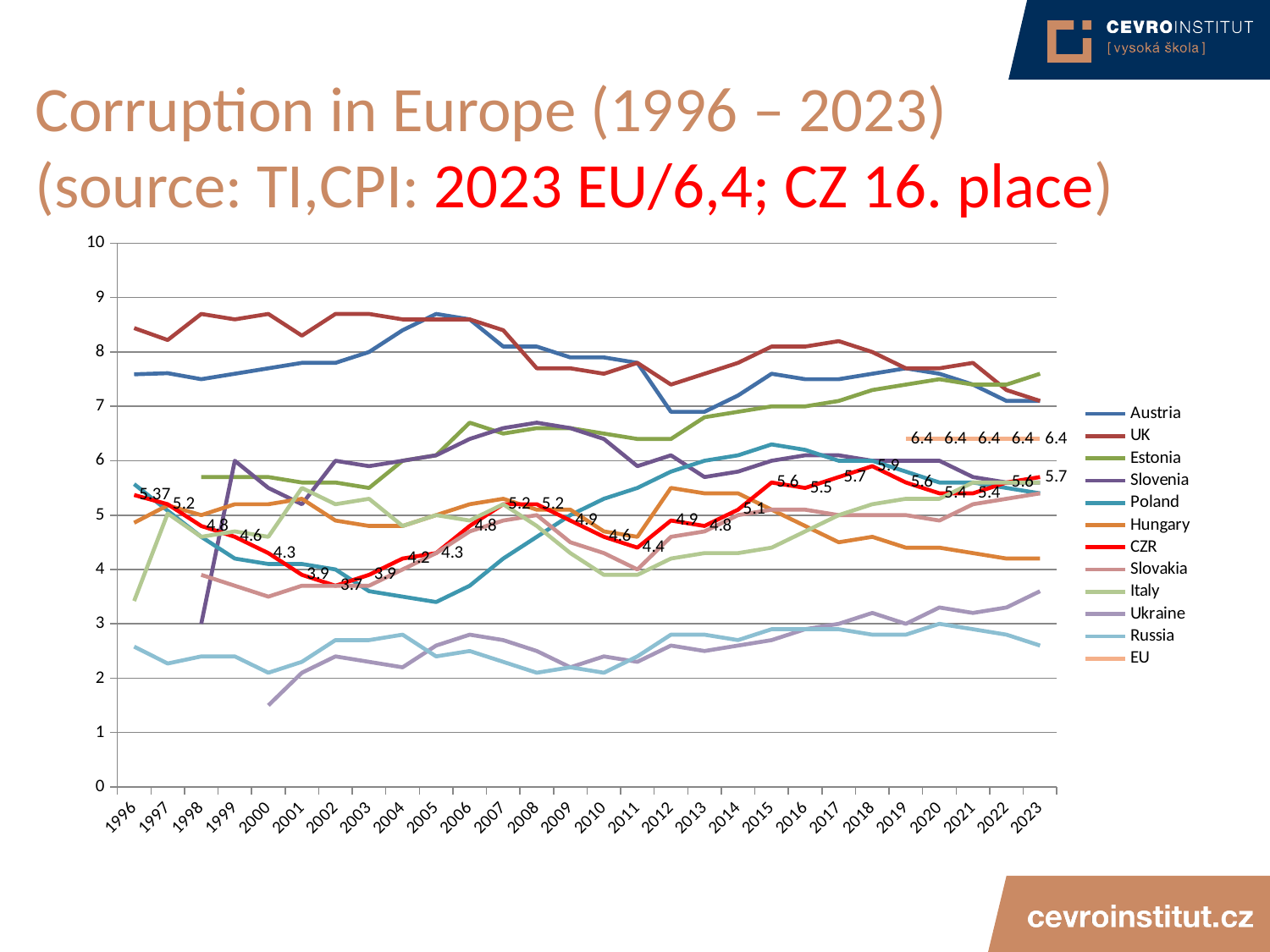
In which year does the CZR series reach its lowest value? 2002 What kind of chart is shown on the slide? line chart What is the difference between the EU value and the CZR value in 2023? 0.7 How many years are shown on the x axis? 28 Is the value for Russia in 2023 greater or less than 3? less What is the EU value shown for 2023? 6.4 Which series has the higher value in 2023, Austria or Poland? Austria How many series does the legend list? 12 Does the CZR series rise or fall from 2014 to 2018? rise What is the CZR value for 2023? 5.7 What is the difference between the CZR value in 2018 and in 2002? 2.2 In which year does the CZR series reach its highest value? 2018